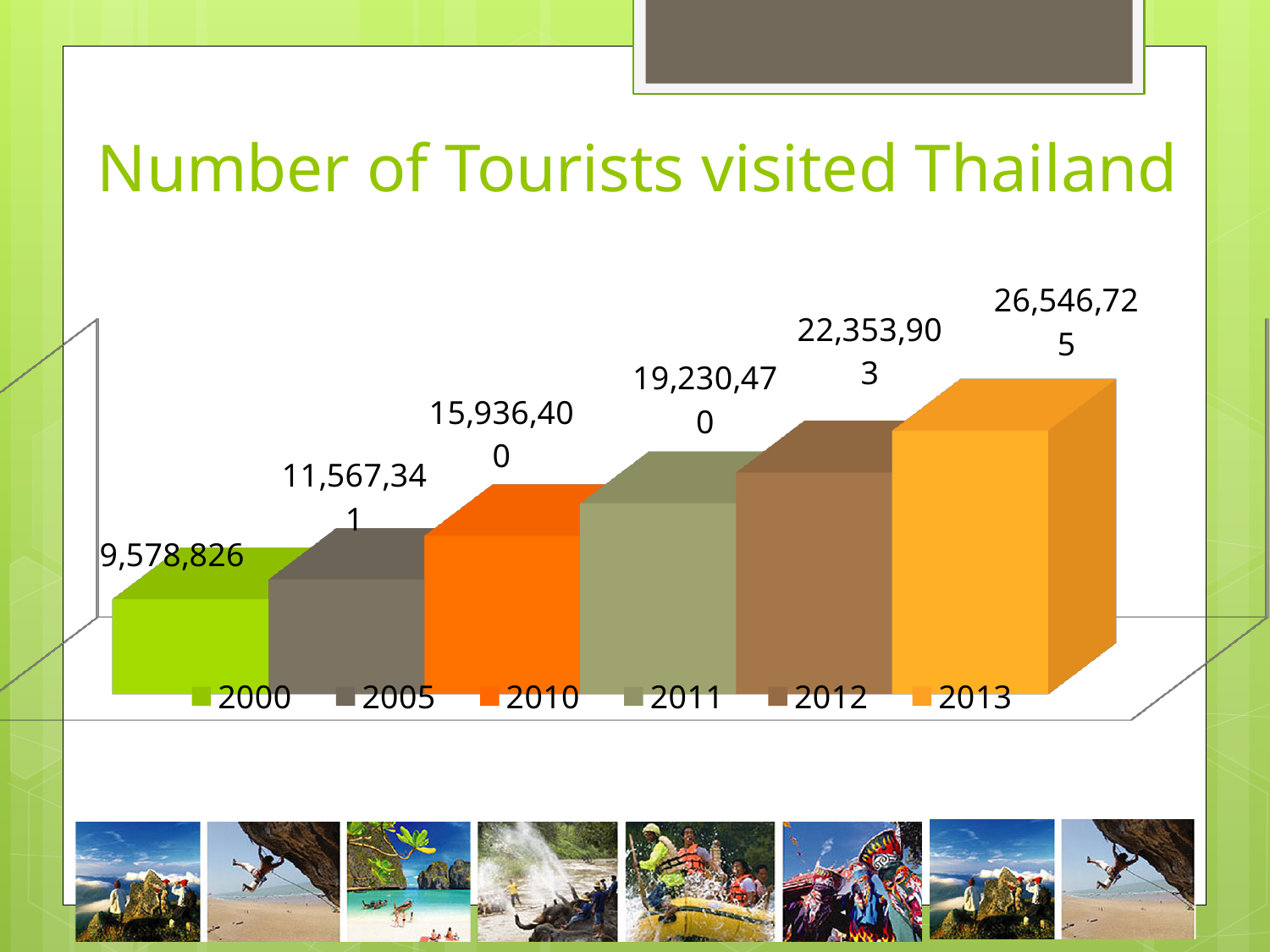
How many bars are shown in the chart? 6 What is the number of tourists for 2000? 9,578,826 What kind of chart is shown on the slide? Bar chart What is the number of tourists for 2013? 26,546,725 Do the values rise or fall from 2000 to 2013? Rise Which year has the highest number of tourists? 2013 What is the number of tourists for 2011? 19,230,470 What is the difference in tourists between 2013 and 2012? 4,192,822 Which year has the lowest number of tourists? 2000 Which year had more tourists, 2010 or 2012? 2012 What is the number of tourists for 2005? 11,567,341 What is the difference in tourists between 2013 and 2000? 16,967,899